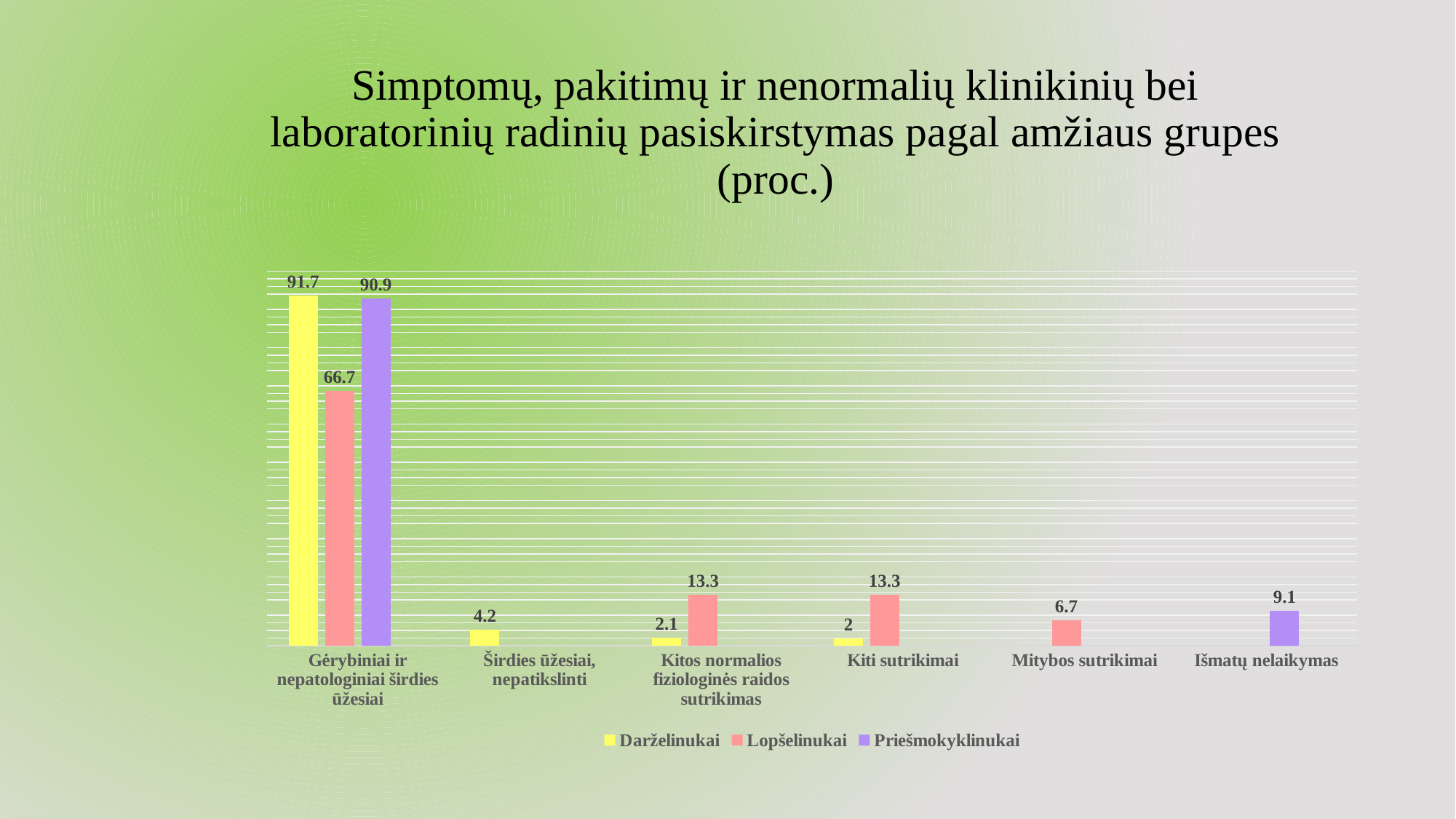
How many series does the legend list? 3 What is the value for Lopšelinukai in the category 'Gėrybiniai ir nepatologiniai širdies ūžesiai'? 66.7 What is the value for Priešmokyklinukai in the category 'Išmatų nelaikymas'? 9.1 What is the difference between the Darželinukai and Lopšelinukai values in the category 'Gėrybiniai ir nepatologiniai širdies ūžesiai'? 25 What is the value for Lopšelinukai in the category 'Mitybos sutrikimai'? 6.7 How many categories are shown on the x axis? 6 Which is larger in the category 'Kitos normalios fiziologinės raidos sutrikimas': the Darželinukai value or the Lopšelinukai value? Lopšelinukai What type of chart is shown on the slide? bar chart Which series has the lowest value in the category 'Kiti sutrikimai'? Darželinukai Which series has the highest value in the category 'Gėrybiniai ir nepatologiniai širdies ūžesiai'? Darželinukai Which colour represents the Priešmokyklinukai series? purple What is the value for Darželinukai in the category 'Gėrybiniai ir nepatologiniai širdies ūžesiai'? 91.7